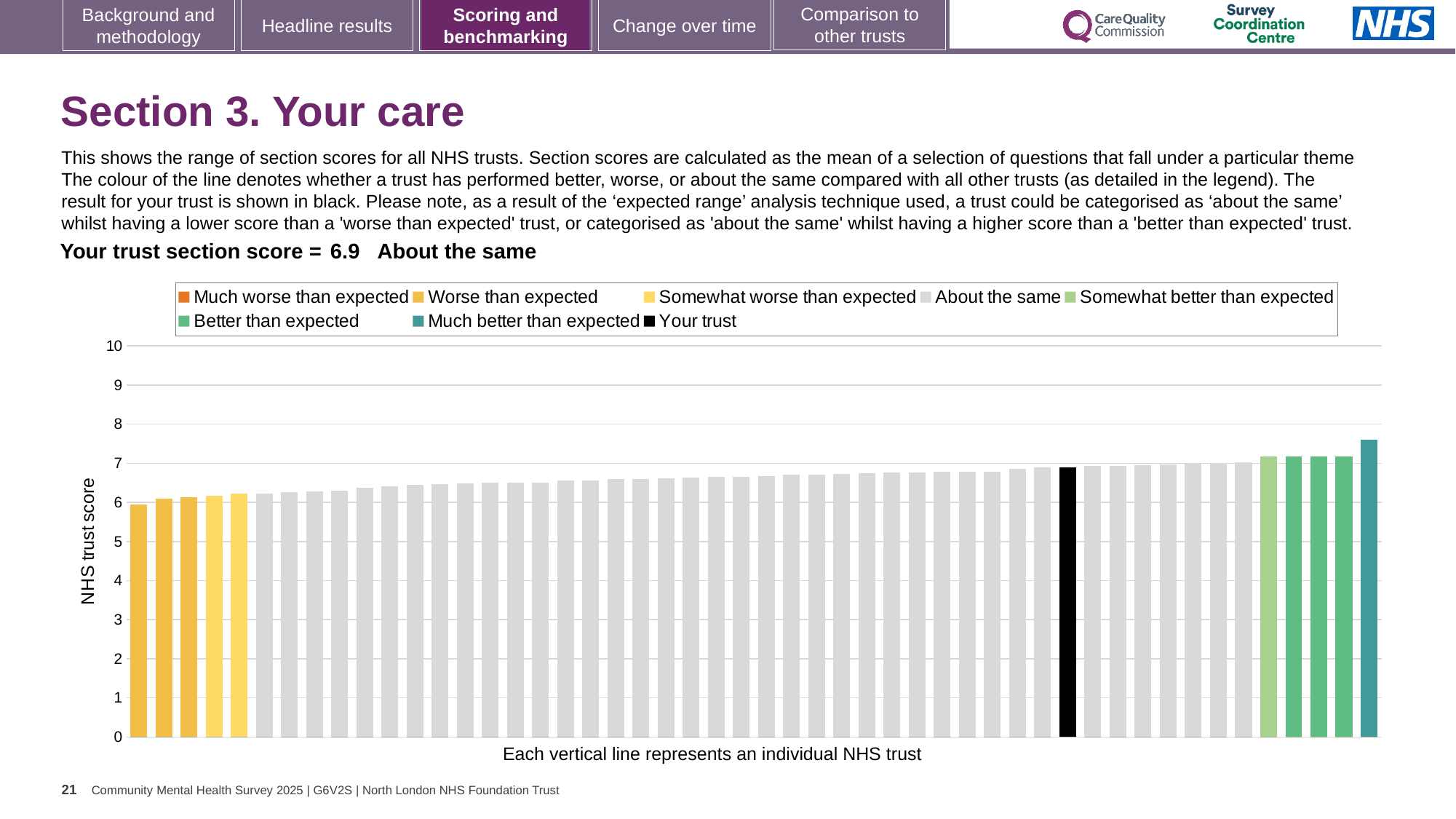
What is the label on the y axis of the chart? NHS trust score What is the section score for your trust shown on the slide? 6.9 Do the bar values rise or fall from left to right along the x axis? Rise According to the legend, what colour is used for 'Your trust'? Black Is the value of the leftmost bar greater or less than 5? greater Is the value of the tallest bar greater or less than 8? less Is the value of the tallest bar (rightmost) greater or less than 7? greater Which category does your trust fall into for this section score? About the same What kind of chart is shown on the slide? Bar chart How many entries does the chart legend list? 8